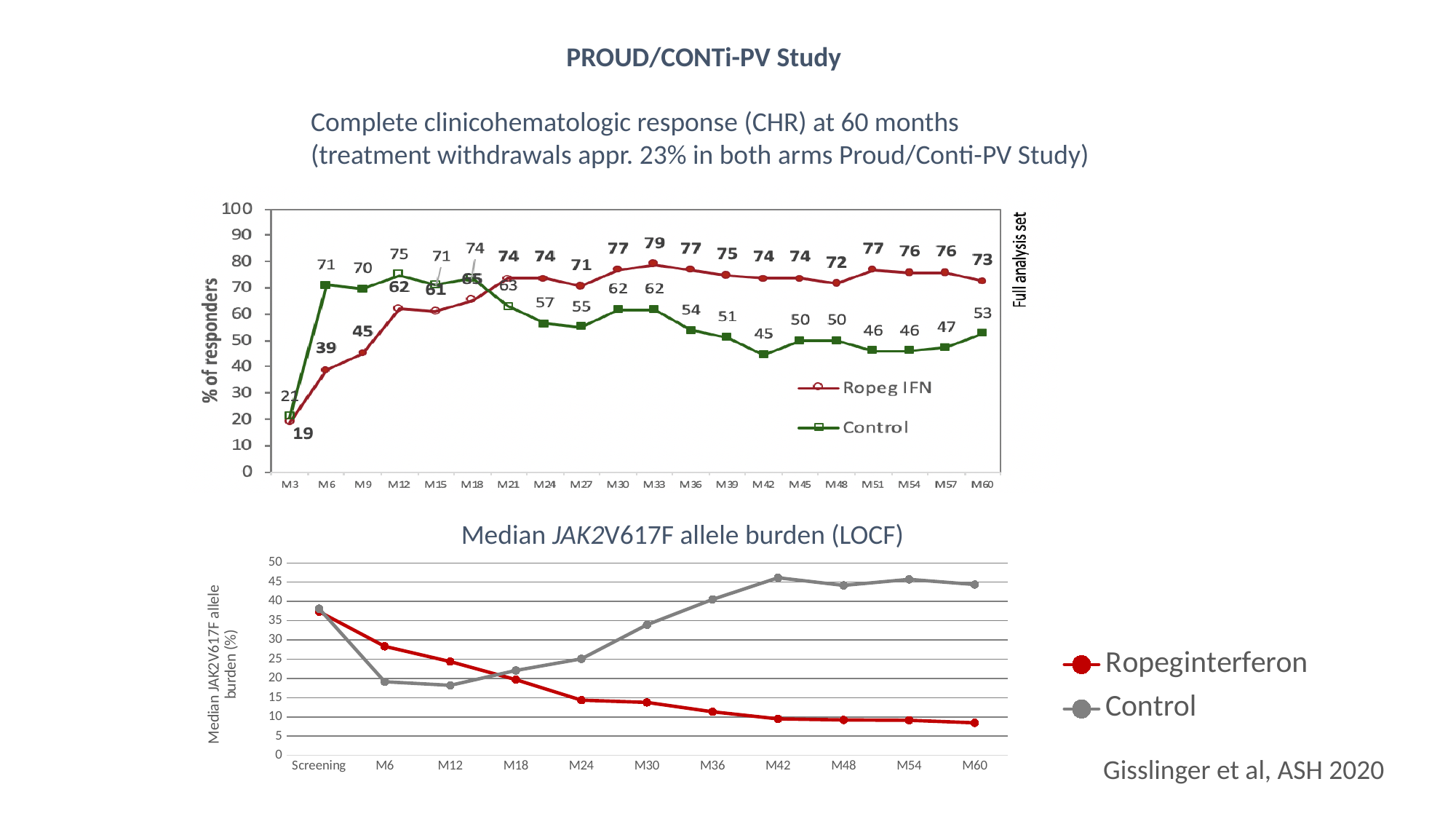
In the top CHR chart, what is the difference between the Ropeg IFN and Control values at M60? 20 In the top CHR chart, what is the Control value at M60? 53 In the top CHR chart, at which month does the Ropeg IFN series reach its highest value? M33 In the top CHR chart, how many series does the legend list? 2 What kind of chart is the Median JAK2V617F allele burden (LOCF) chart? Line chart In the Median JAK2V617F allele burden chart, is the Ropeginterferon value at M60 greater or less than 10? less In the Median JAK2V617F allele burden chart, does the Ropeginterferon series rise or fall from Screening to M60? Fall In the top CHR chart, which series has the higher value at M12, Ropeg IFN or Control? Control In the top CHR chart, how many time points are shown on the x axis? 20 In the Median JAK2V617F allele burden chart, is the Control value at M42 greater or less than 40? greater In the top CHR chart, what is the Ropeg IFN value at M33? 79 In the top CHR chart, at which month is the Control series lowest after M3? M42